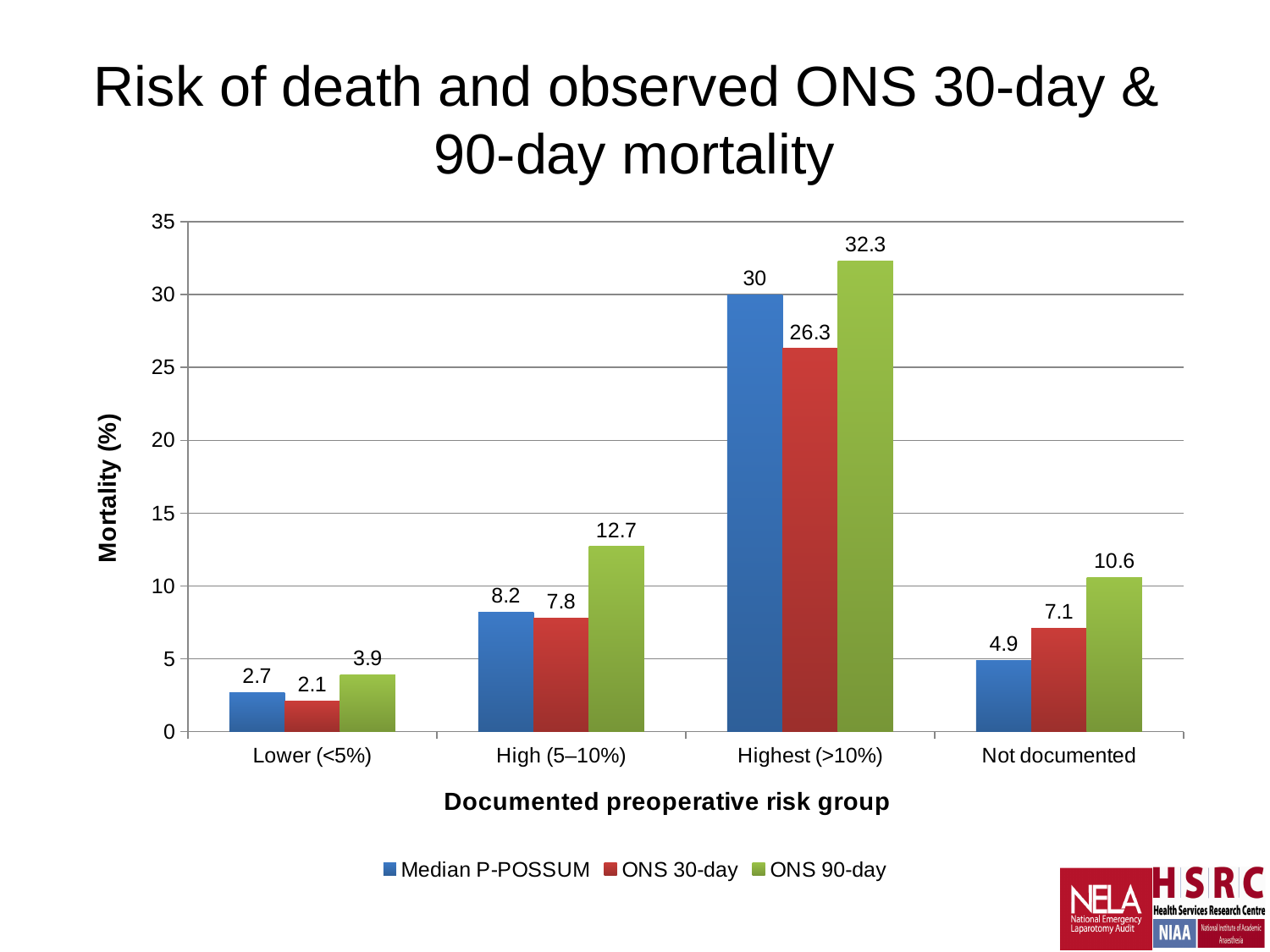
What is the ONS 30-day mortality for the Not documented group? 7.1 Is the Median P-POSSUM value for the Highest (>10%) group greater or less than 25? greater Which risk group has the lowest ONS 90-day mortality? Lower (<5%) For the Not documented group, which is larger: Median P-POSSUM or ONS 90-day? ONS 90-day What kind of chart is shown on the slide? Bar chart What is the ONS 90-day mortality for the Highest (>10%) risk group? 32.3 Which risk group has the highest ONS 30-day mortality? Highest (>10%) What is the label of the y axis? Mortality (%) How many risk groups are shown on the x axis? 4 What is the difference between the ONS 90-day and ONS 30-day mortality for the Highest (>10%) group? 6 How many series does the legend list? 3 What is the Median P-POSSUM value for the High (5–10%) risk group? 8.2